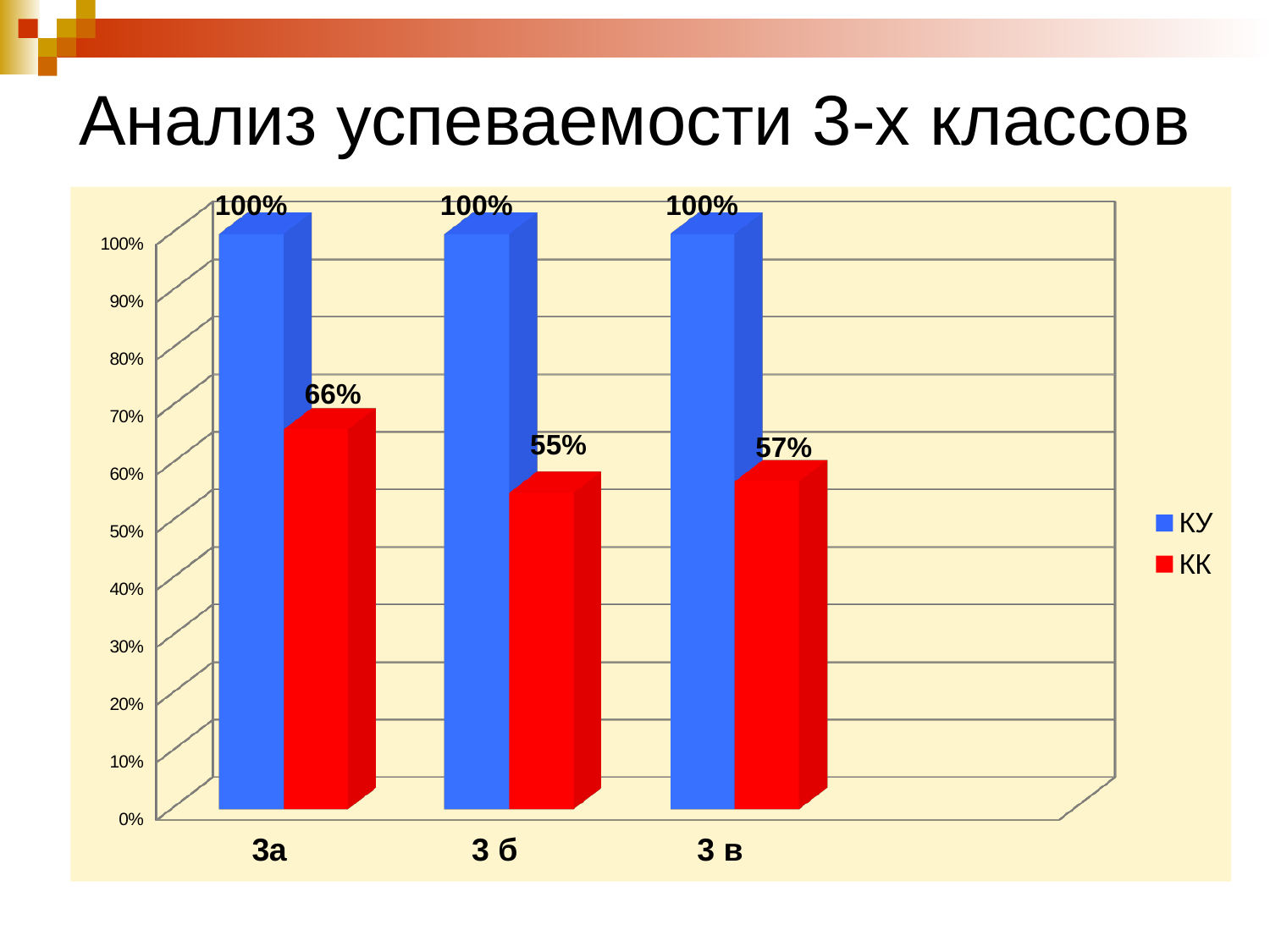
What is the КК value for class 3 б? 55% Which class has the lowest КК value? 3 б How many classes are shown on the x axis? 3 Which is larger, the КК value for 3 в or the КК value for 3 б? 3 в What kind of chart is shown on the slide? bar chart What is the КУ value for class 3 в? 100% What is the difference between the КУ and КК values for class 3 в? 43% What is the difference between the КК values for 3а and 3 б? 11% How many series does the legend list? 2 What is the КК value for class 3а? 66% What is the title of the slide? Анализ успеваемости 3-х классов Which class has the highest КК value? 3а